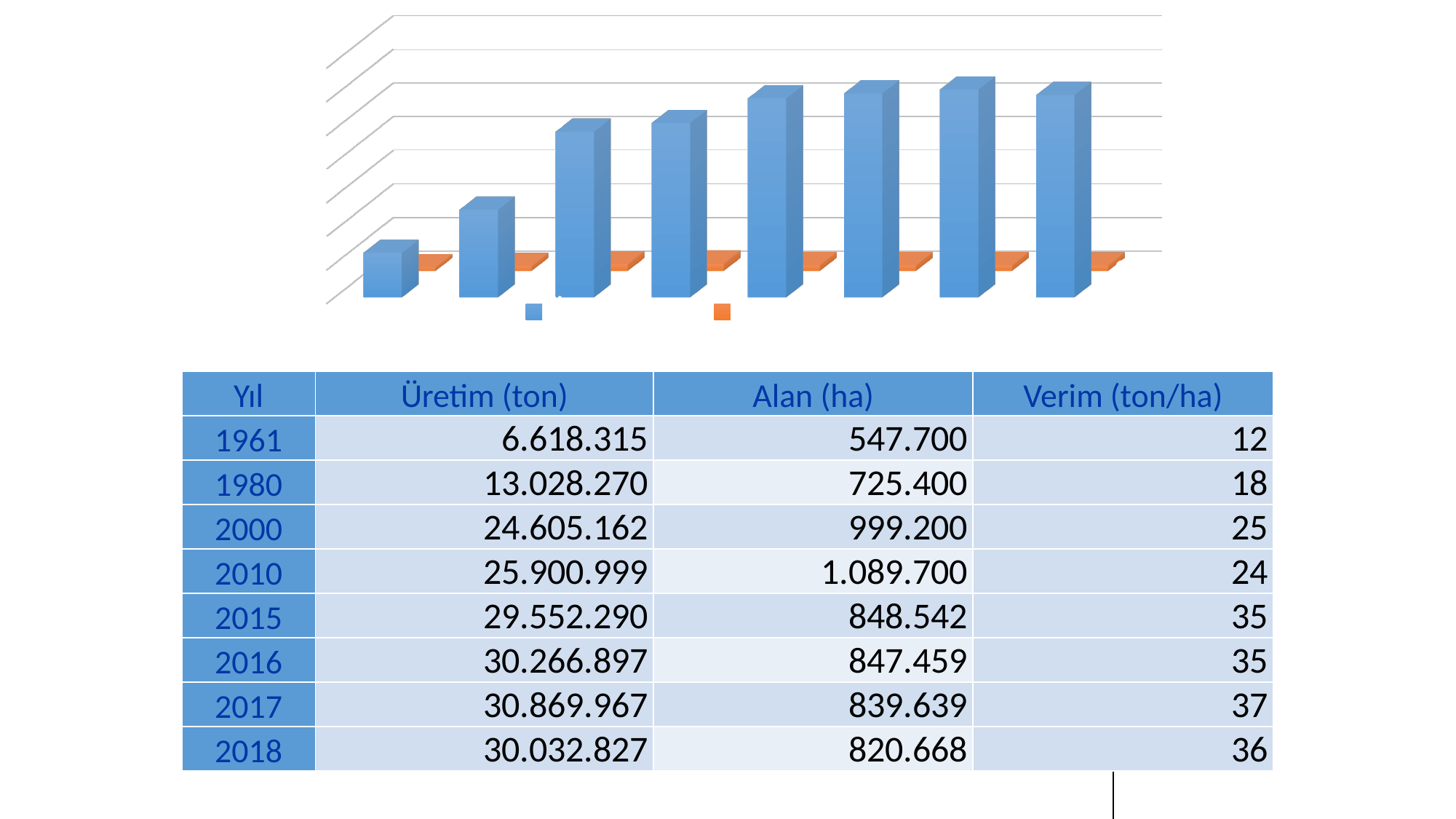
How many blue bars are plotted in the chart? 8 What colour are the short flat bars at the base of the chart? orange What kind of chart is shown at the top of the slide? bar chart Which of the two series in the chart is drawn in blue, the taller bars or the flat bars near the base? the taller bars How many series does the chart's legend list? 2 Do the blue bars generally rise or fall from left to right across the chart? rise Is the third blue bar from the left taller or shorter than the second blue bar? taller Is the first blue bar from the left taller or shorter than the second blue bar? shorter